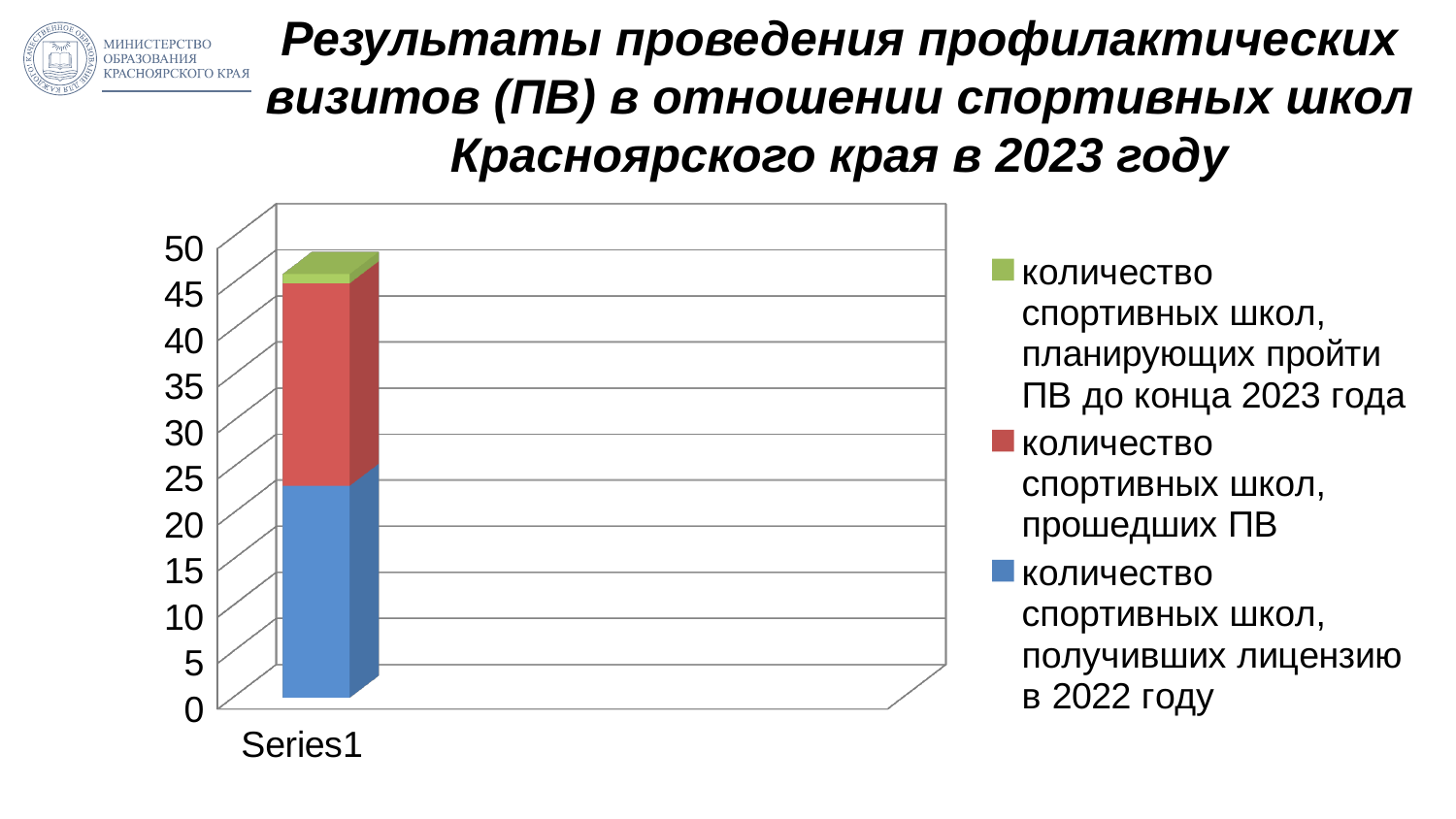
Which series has the smallest segment in the stacked bar? количество спортивных школ, планирующих пройти ПВ до конца 2023 года Which series is represented by the green colour in the legend? количество спортивных школ, планирующих пройти ПВ до конца 2023 года Which is larger: the segment for 'количество спортивных школ, прошедших ПВ' or the segment for 'количество спортивных школ, планирующих пройти ПВ до конца 2023 года'? количество спортивных школ, прошедших ПВ What is the label of the single category on the x axis? Series1 How many series does the legend list? 3 Is the value for 'количество спортивных школ, получивших лицензию в 2022 году' greater or less than 20? greater What kind of chart is shown on the slide? stacked bar chart Is the total height of the stacked bar greater or less than 50? less Is the value for 'количество спортивных школ, планирующих пройти ПВ до конца 2023 года' greater or less than 5? less How many categories are plotted on the x axis? 1